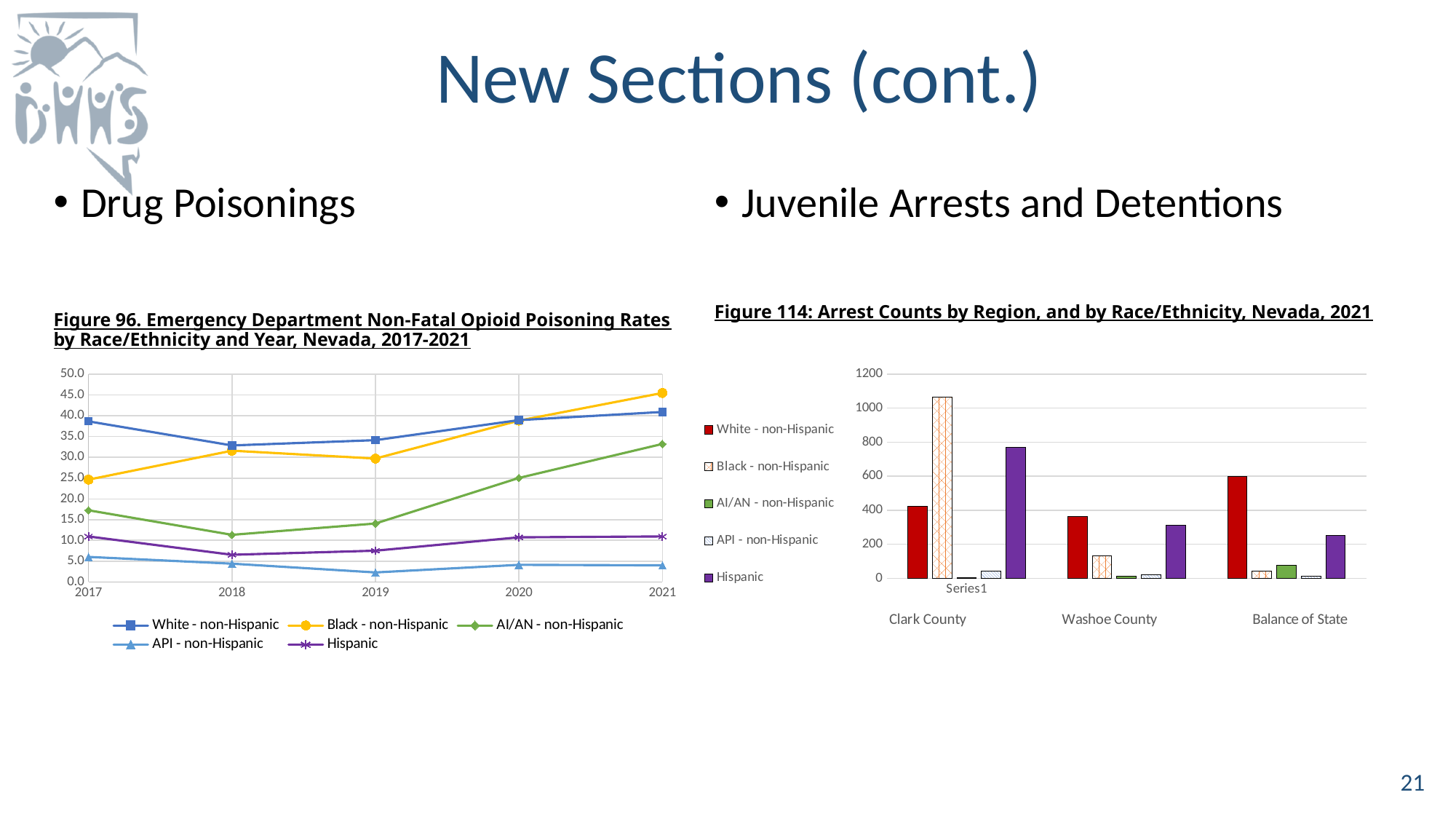
In Figure 114, which race/ethnicity group has the highest arrest count in Clark County? Black - non-Hispanic In Figure 96, is the 2021 value for Black - non-Hispanic greater or less than 40.0? greater In Figure 96, which race/ethnicity group has the lowest rate in 2021? API - non-Hispanic In Figure 114, which is larger in Washoe County: White - non-Hispanic or Hispanic? White - non-Hispanic In Figure 96, does the AI/AN - non-Hispanic rate rise or fall from 2019 to 2021? rise In Figure 96, which race/ethnicity group has the highest rate in 2021? Black - non-Hispanic How many regions are shown on the x axis of Figure 114? 3 What type of chart is Figure 114? bar chart What type of chart is Figure 96? line chart How many series does the legend of Figure 96 list? 5 In Figure 114, is the Clark County value for Black - non-Hispanic greater or less than 1000? greater How many years are shown on the x axis of Figure 96? 5